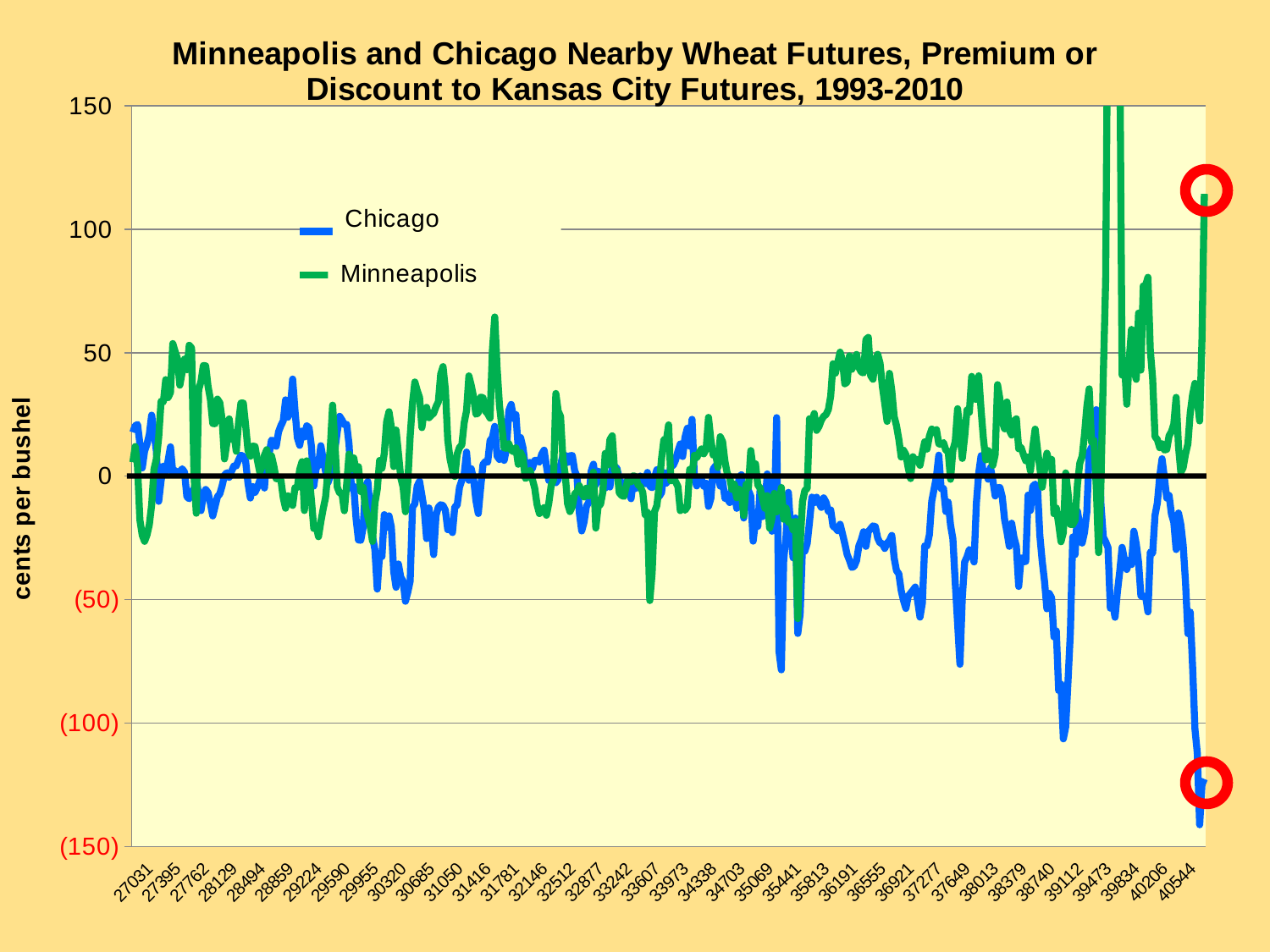
Is the final (rightmost) value of the Minneapolis series greater or less than 100? greater At the far right end of the chart, which series is higher, Chicago or Minneapolis? Minneapolis What is the label on the vertical axis? cents per bushel Is the final (rightmost) value of the Chicago series greater or less than (100)? less Is the lowest value reached by the Chicago series greater or less than (100)? less What kind of chart is shown on the slide? line chart How many series does the legend list? 2 Which series reaches the lowest value anywhere on the chart? Chicago What are the two series named in the legend? Chicago and Minneapolis Which series reaches the highest value anywhere on the chart? Minneapolis Over the last portion of the chart (from about 40206 to 40544), does the Chicago series rise or fall? fall